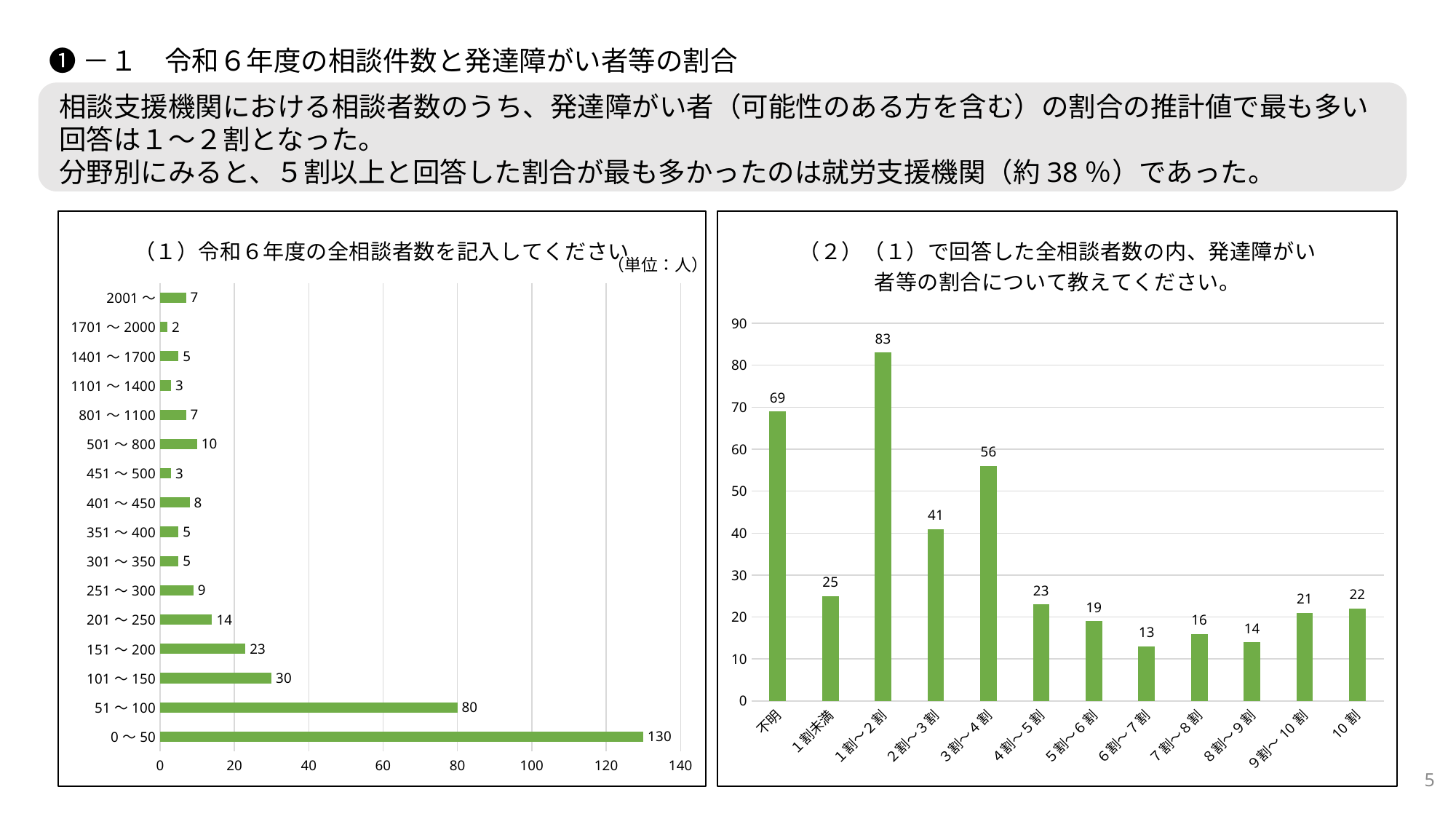
In the left chart (1), which is larger, the value for 201～250 or the value for 251～300? 201～250 In the right chart (2), what is the value for 1割～2割? 83 In the left chart (1), which category has the highest value? 0～50 In the left chart (1), what is the value for 151～200? 23 In the right chart (2), how many categories are shown on the x axis? 12 In the left chart (1), what is the difference between the values for 0～50 and 51～100? 50 In the right chart (2), what is the difference between the values for 不明 and 3割～4割? 13 In the right chart (2), which category has the lowest value? 6割～7割 In the left chart (1), how many categories are shown? 16 In the right chart (2), what is the value for 10割? 22 In the left chart (1), what is the value for the 0～50 category? 130 In the left chart (1), what kind of chart is it? Bar chart